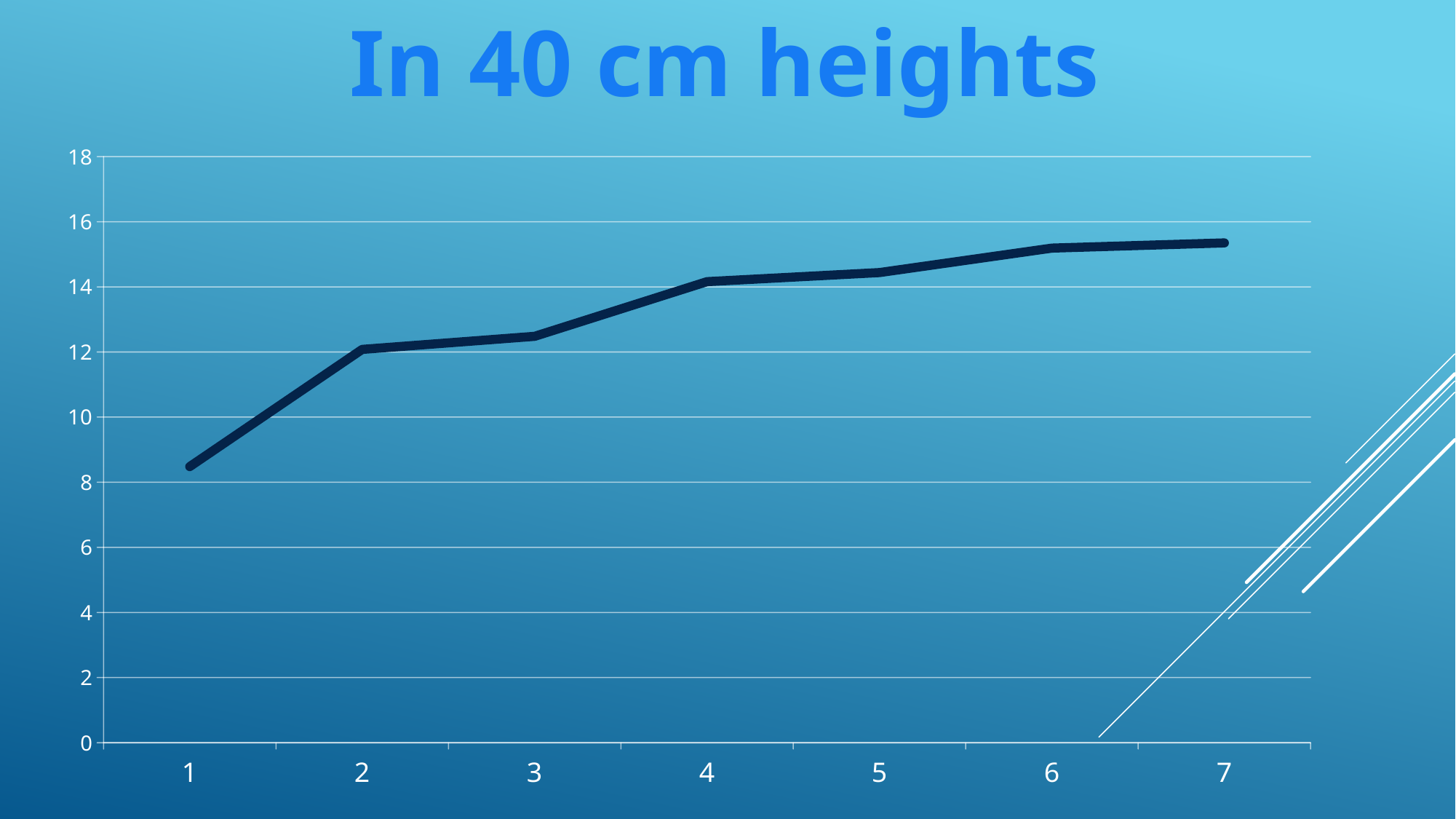
How many data points are plotted on the line? 7 Which has the larger value, point 3 or point 6? 6 Is the value at point 6 greater or less than 14? greater What is the title of the chart? In 40 cm heights Is the value at point 1 greater or less than 10? less Do the values generally rise or fall from point 1 to point 7? rise Which point on the x axis has the lowest value? 1 Which has the larger value, point 1 or point 4? 4 What kind of chart is shown on the slide? line chart Is the value at point 7 greater or less than 16? less